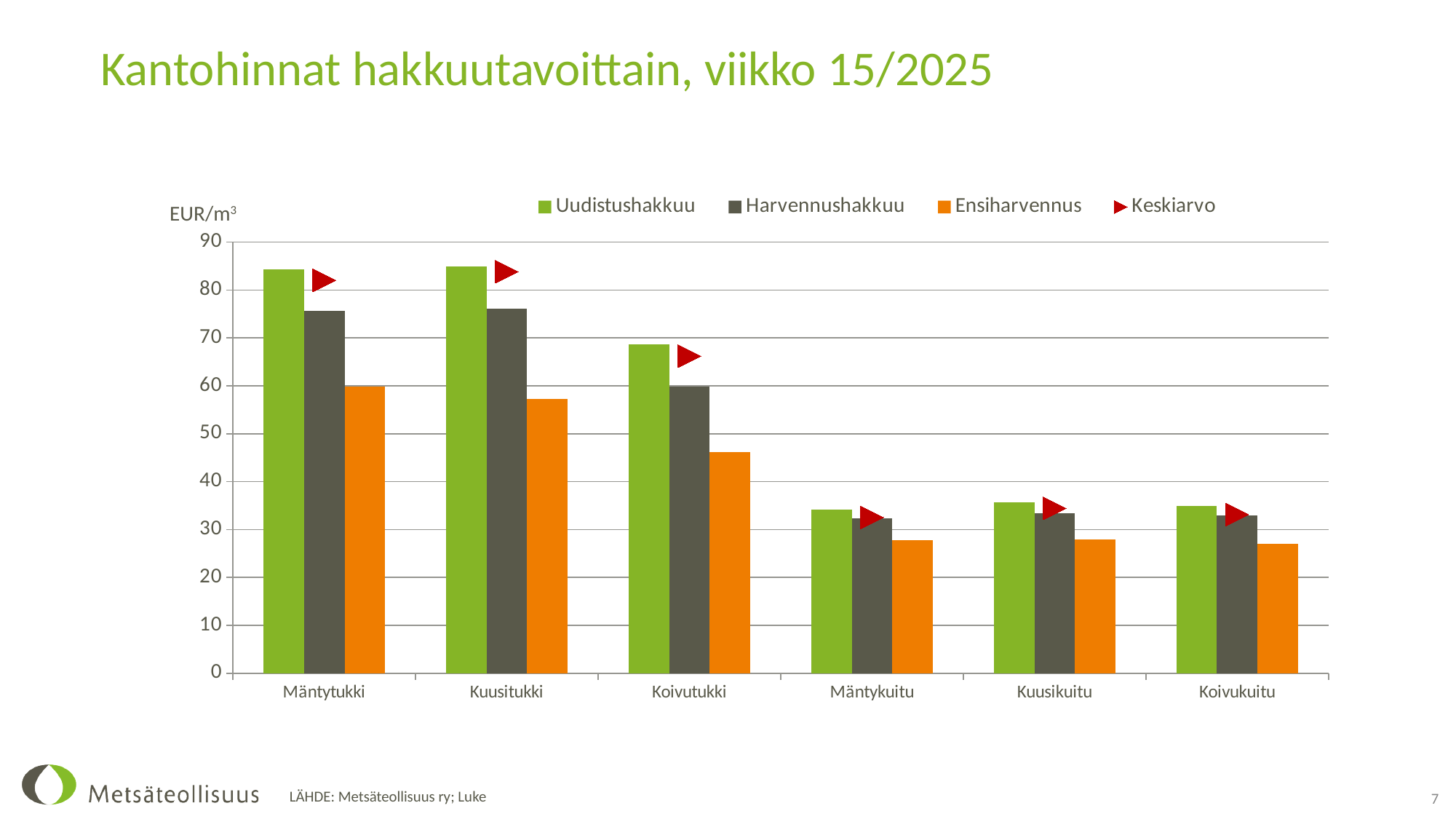
Which is larger, the Uudistushakkuu value for Mäntytukki or for Koivutukki? Mäntytukki How many categories are shown on the x axis? 6 Is the Ensiharvennus value for Koivutukki greater or less than 50? less What unit is shown on the y axis? EUR/m³ What kind of chart is shown on the slide? Bar chart Which is larger, the Ensiharvennus value for Kuusitukki or for Koivutukki? Kuusitukki How many series does the legend list? 4 For Koivutukki, which series has the higher value, Uudistushakkuu or Ensiharvennus? Uudistushakkuu Is the Harvennushakkuu value for Kuusitukki greater or less than 70? greater Is the Uudistushakkuu value for Mäntytukki greater or less than 80? greater Which series is shown with red triangle markers? Keskiarvo